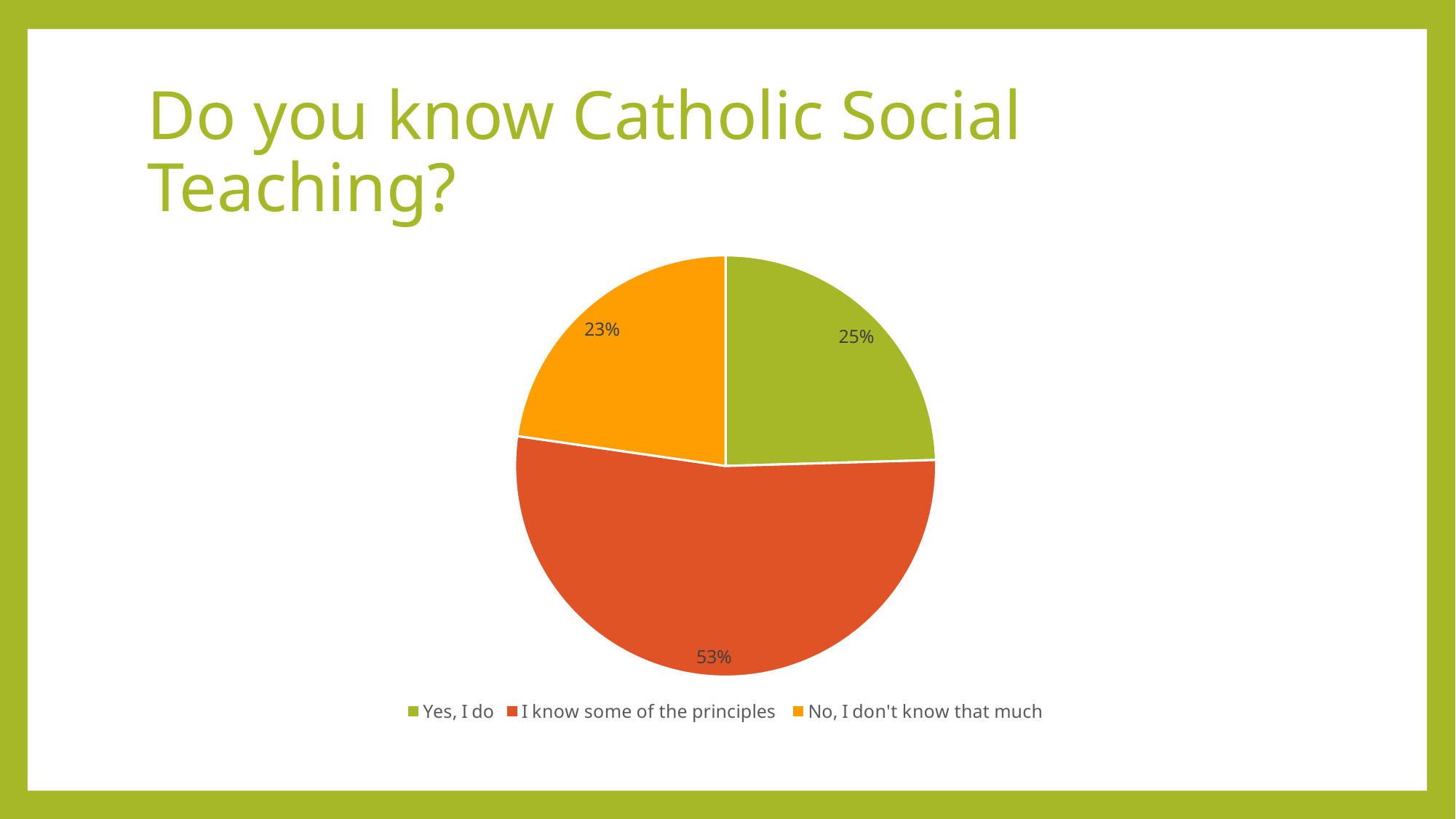
What share of the pie is labelled "I know some of the principles"? 53% What share of the pie is labelled "Yes, I do"? 25% Which response has the largest share of the pie? I know some of the principles What kind of chart is shown on the slide? Pie chart What is the title of the slide containing the pie chart? Do you know Catholic Social Teaching? Which is larger: the share for "Yes, I do" or the share for "No, I don't know that much"? Yes, I do How many entries does the legend list? 3 Which response has the smallest share of the pie? No, I don't know that much What colour is the slice for "No, I don't know that much"? Orange How many slices does the pie chart have? 3 What share of the pie is labelled "No, I don't know that much"? 23% What is the difference in percentage points between "I know some of the principles" and "Yes, I do"? 28